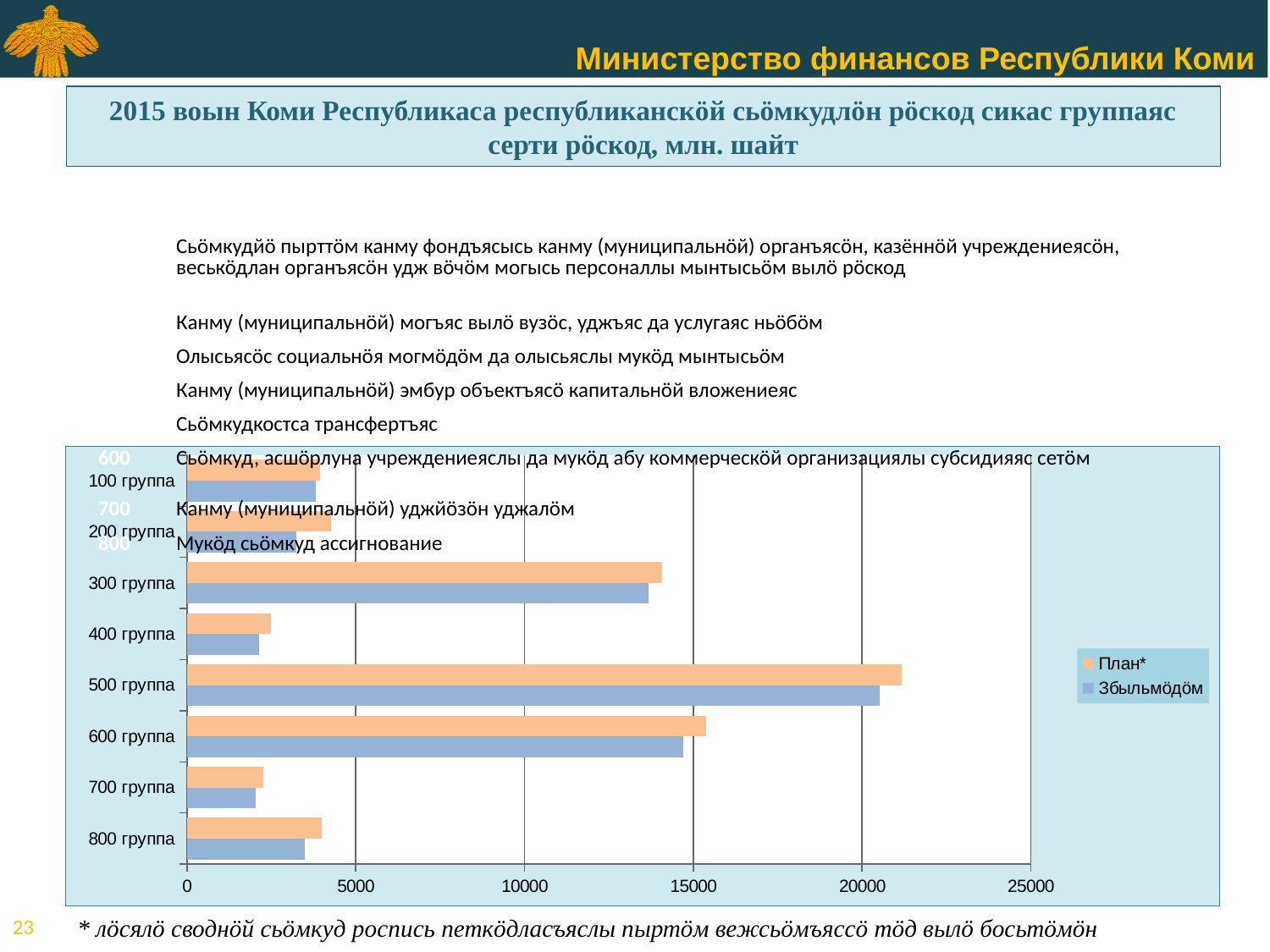
Is the План* value for 300 группа greater or less than 10000? greater Which group has the highest Збыльмӧдӧм value? 500 группа Is the Збыльмӧдӧм value for 600 группа greater or less than 10000? greater Is the План* value for 500 группа greater or less than 20000? greater How many categories (groups) are plotted on the chart? 8 How many series does the chart legend list? 2 Which group has the highest План* value? 500 группа For 500 группа, which is larger, the План* value or the Збыльмӧдӧм value? План* What kind of chart is shown on the slide? bar chart What are the two series names shown in the chart legend? План* and Збыльмӧдӧм Which is larger, the План* value for 300 группа or for 600 группа? 600 группа